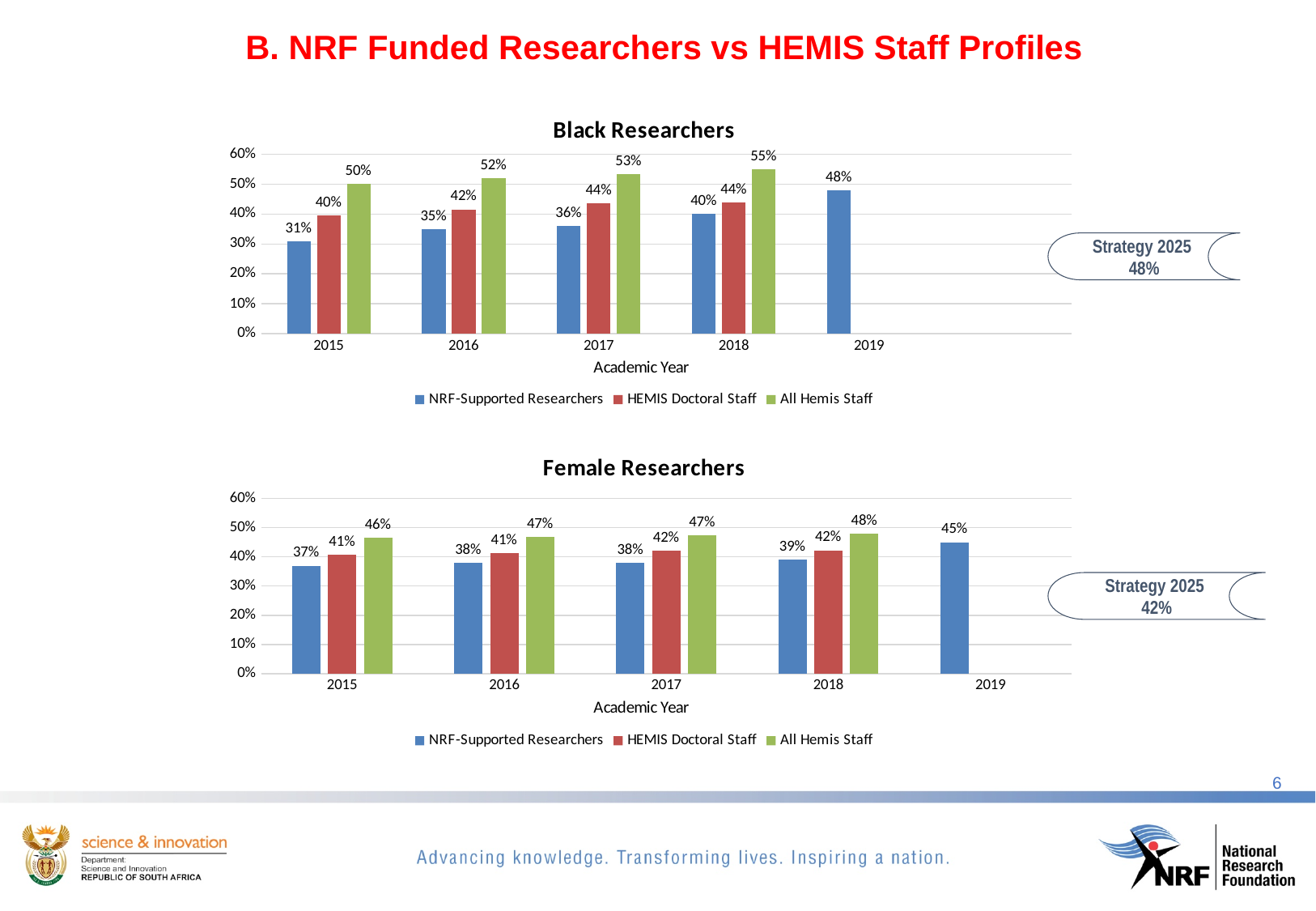
What kind of chart is the Female Researchers chart? bar chart In the Black Researchers chart, what is the value for All Hemis Staff in 2018? 55% In the Black Researchers chart, do the NRF-Supported Researchers values rise or fall from 2015 to 2019? rise In the Female Researchers chart, what is the value for NRF-Supported Researchers in 2019? 45% In the Black Researchers chart, how many series does the legend list? 3 In the Black Researchers chart, what is the value for NRF-Supported Researchers in 2019? 48% In the Female Researchers chart, what is the difference between All Hemis Staff and NRF-Supported Researchers in 2015? 9% In the Black Researchers chart, what is the difference between All Hemis Staff and NRF-Supported Researchers in 2017? 17% In the Female Researchers chart, what is the value for HEMIS Doctoral Staff in 2017? 42% In the Female Researchers chart, which year has the highest All Hemis Staff value? 2018 In the Black Researchers chart, what is the value for NRF-Supported Researchers in 2015? 31% In the Female Researchers chart, which is larger in 2016: NRF-Supported Researchers or All Hemis Staff? All Hemis Staff